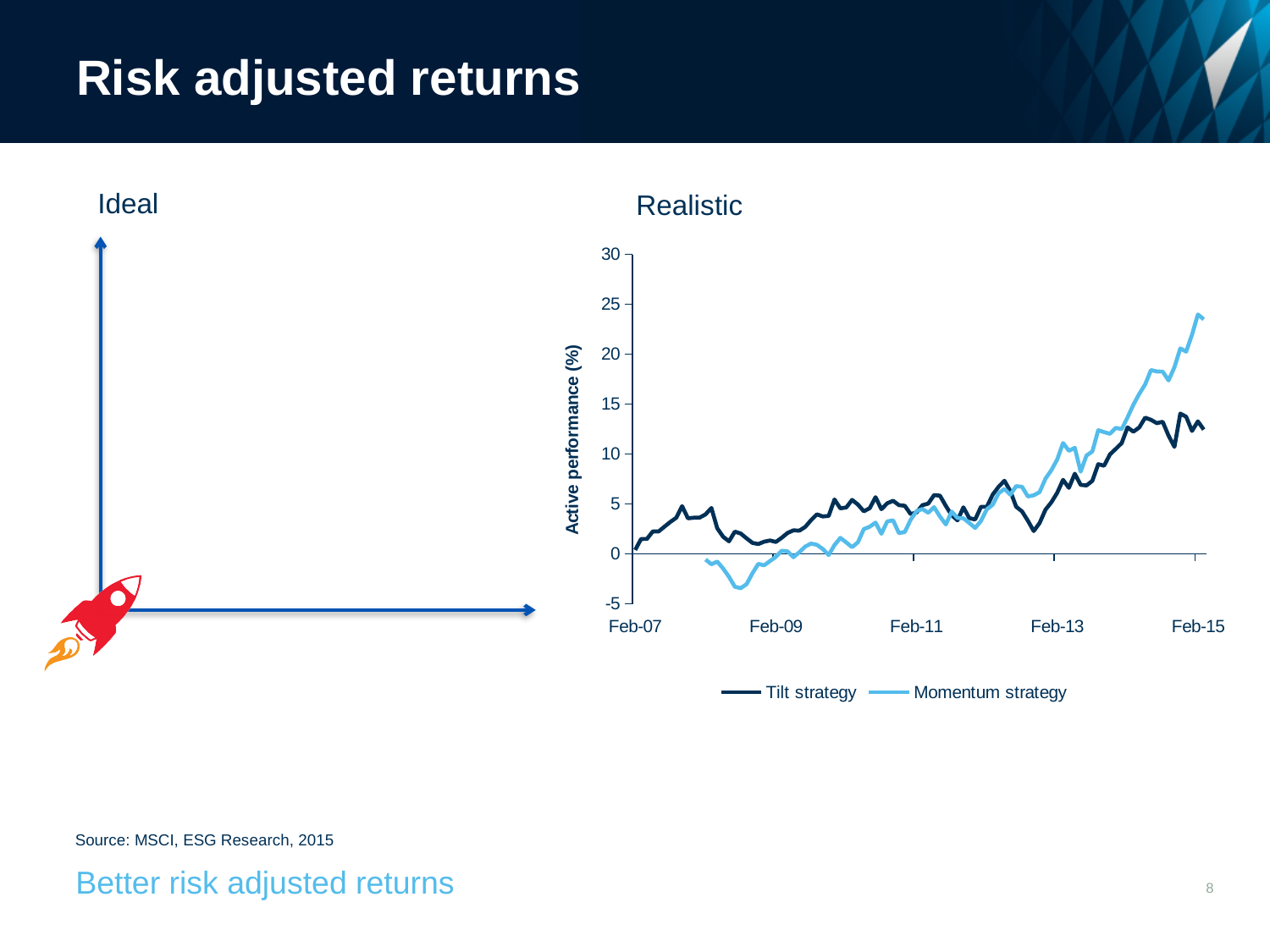
What are the two series named in the legend of the "Realistic" chart? Tilt strategy and Momentum strategy In the "Realistic" chart, which series is higher at Feb-15, Tilt strategy or Momentum strategy? Momentum strategy What is the y-axis label of the "Realistic" chart? Active performance (%) In the "Realistic" chart, does the Momentum strategy line overall rise or fall from Feb-09 to Feb-15? rise In the "Realistic" chart, is the value of the Tilt strategy at Feb-13 greater or less than 10? less What kind of chart is the "Realistic" chart on the slide? line chart How many series does the legend of the "Realistic" chart list? 2 How many date labels are shown on the x axis of the "Realistic" chart? 5 In the "Realistic" chart, which series reaches the highest value on the chart? Momentum strategy In the "Realistic" chart, is the value of the Tilt strategy at Feb-15 greater or less than 15? less In the "Realistic" chart, is the value of the Momentum strategy at Feb-15 greater or less than 20? greater